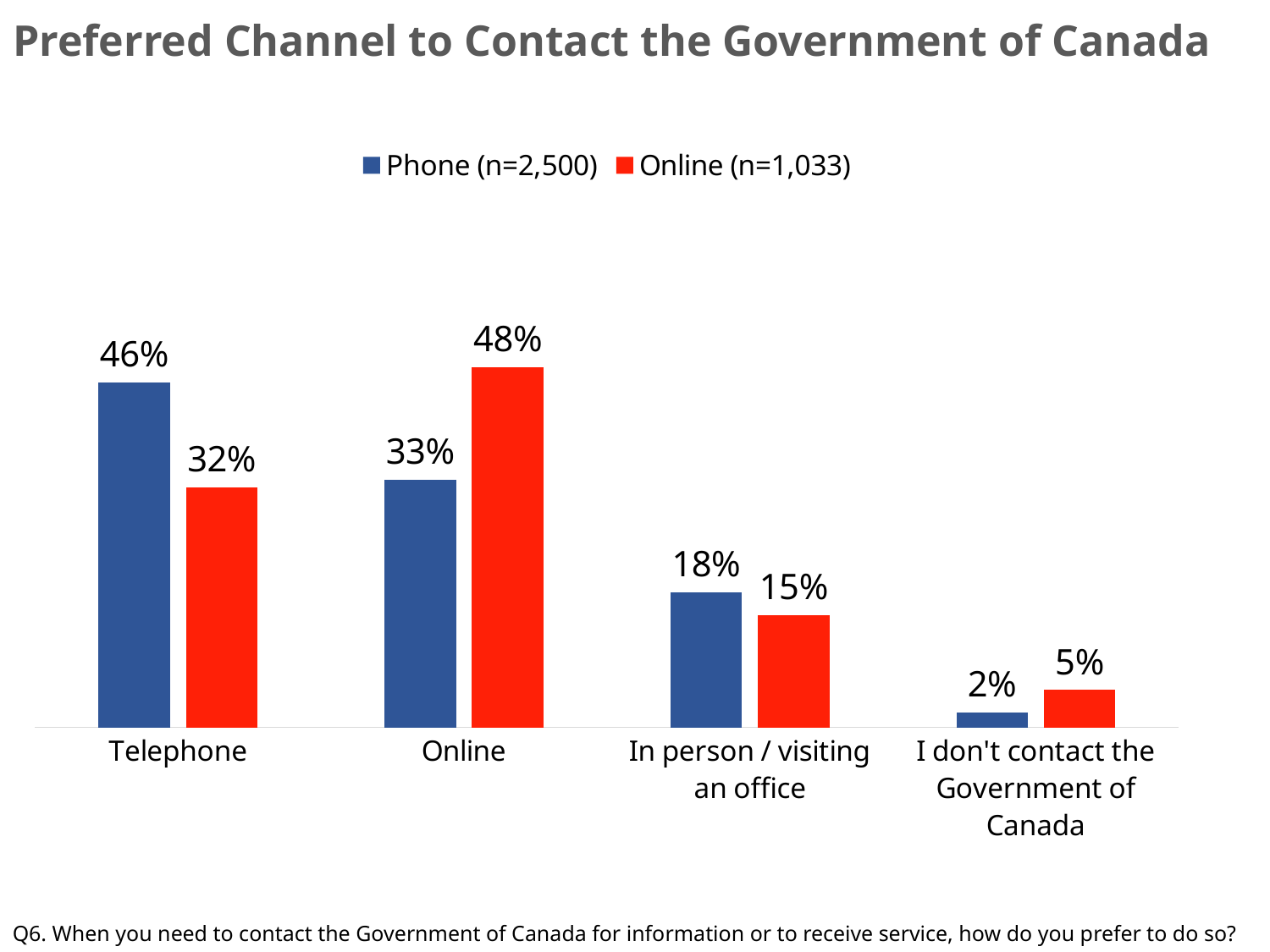
What percentage of Online respondents prefer the Online channel? 48% For the 'In person / visiting an office' category, which series has the larger value, Phone or Online? Phone How many categories are shown on the x axis? 4 Which category has the highest value for the Phone (n=2,500) series? Telephone What is the value for Phone respondents who say 'I don't contact the Government of Canada'? 2% What is the value for Online respondents in the 'In person / visiting an office' category? 15% What is the difference between the Phone and Online values for the Telephone category? 14 percentage points What kind of chart is shown on the slide? Bar chart What percentage of Phone respondents prefer Telephone as their channel to contact the Government of Canada? 46% How many series does the legend list? 2 What is the difference between the Online and Phone values for the Online category? 15 percentage points Which category has the lowest value for the Online (n=1,033) series? I don't contact the Government of Canada